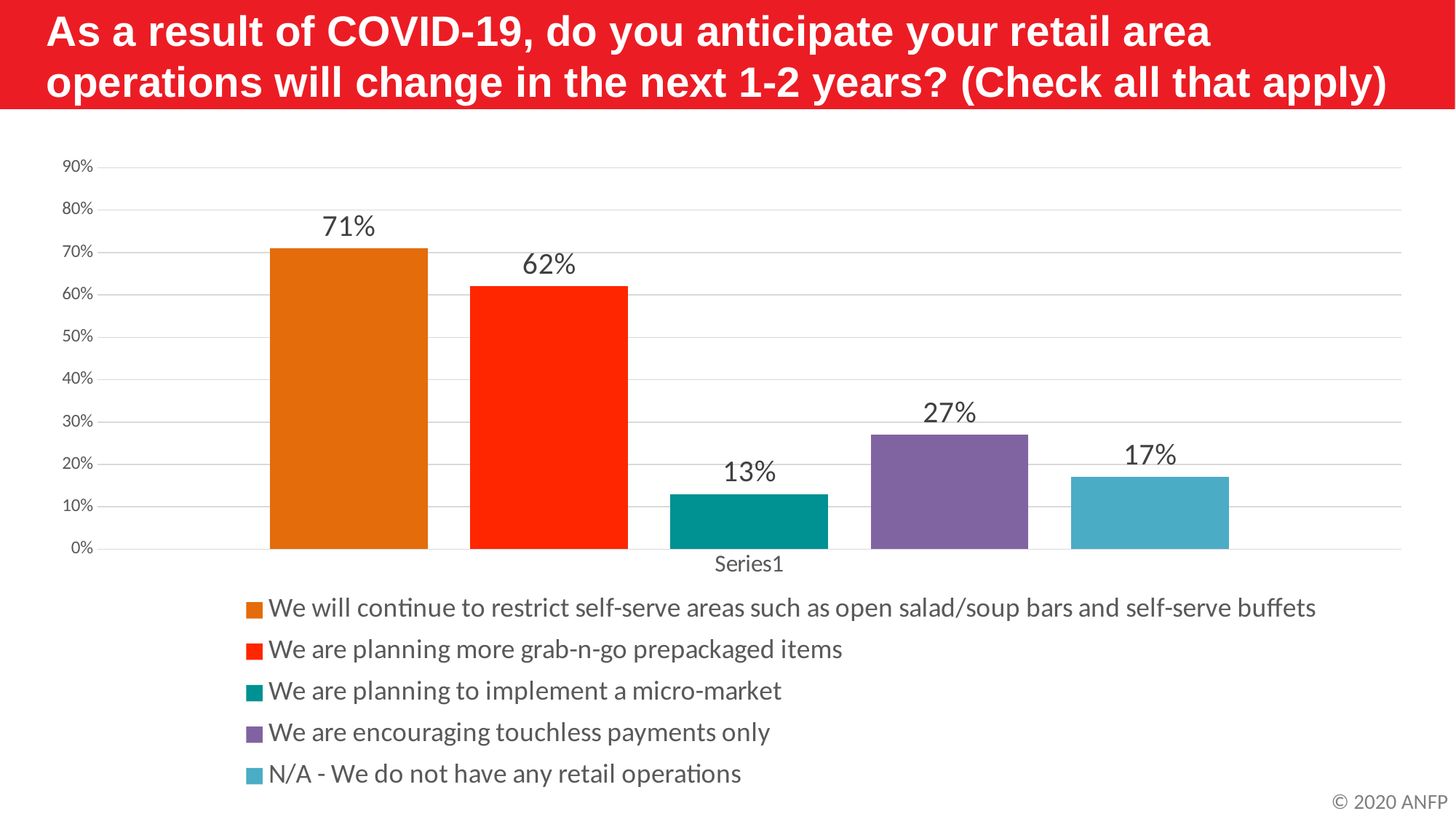
Which response has the highest percentage? We will continue to restrict self-serve areas such as open salad/soup bars and self-serve buffets How many response categories are shown in the chart? 5 What percentage of respondents are planning more grab-n-go prepackaged items? 62% Which is larger: the percentage encouraging touchless payments only or the percentage with no retail operations? We are encouraging touchless payments only What type of chart is shown on the slide? Bar chart What is the difference in percentage points between continuing to restrict self-serve areas and planning more grab-n-go prepackaged items? 9 percentage points What percentage of respondents answered N/A - We do not have any retail operations? 17% Which response has the lowest percentage? We are planning to implement a micro-market What percentage of respondents are planning to implement a micro-market? 13% What percentage of respondents are encouraging touchless payments only? 27% What percentage of respondents said they will continue to restrict self-serve areas such as open salad/soup bars and self-serve buffets? 71% What colour is the bar for 'We are planning more grab-n-go prepackaged items'? Red